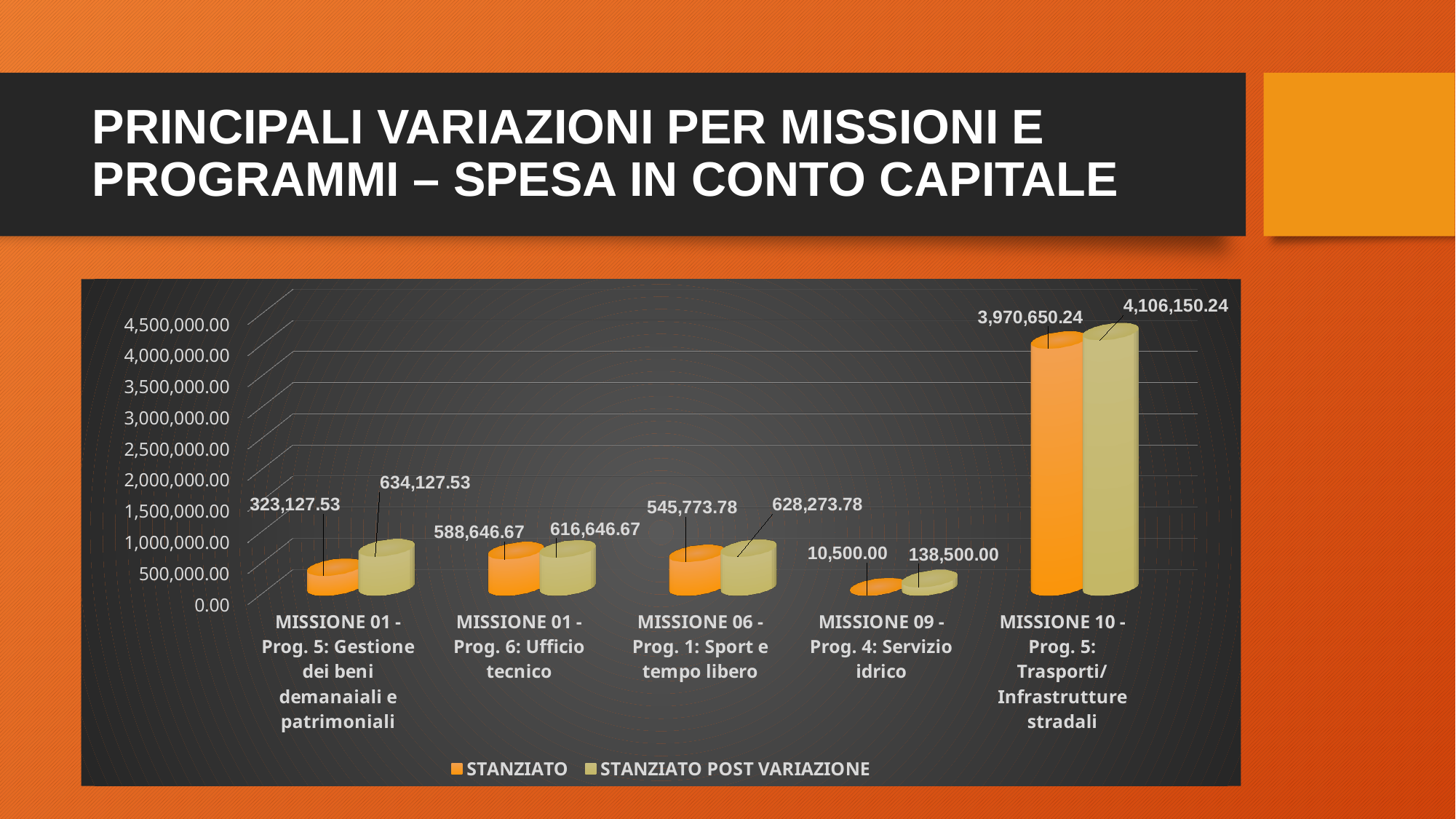
Which category has the highest STANZIATO value? MISSIONE 10 - Prog. 5: Trasporti/Infrastrutture stradali What is the STANZIATO POST VARIAZIONE value for MISSIONE 10 - Prog. 5: Trasporti/Infrastrutture stradali? 4,106,150.24 What is the STANZIATO POST VARIAZIONE value for MISSIONE 01 - Prog. 6: Ufficio tecnico? 616,646.67 Which is larger: the STANZIATO value for MISSIONE 01 - Prog. 6: Ufficio tecnico or the STANZIATO value for MISSIONE 06 - Prog. 1: Sport e tempo libero? MISSIONE 01 - Prog. 6: Ufficio tecnico What is the STANZIATO value for MISSIONE 06 - Prog. 1: Sport e tempo libero? 545,773.78 What is the difference between the STANZIATO POST VARIAZIONE and STANZIATO values for MISSIONE 01 - Prog. 5: Gestione dei beni demaniali e patrimoniali? 311,000.00 What is the difference between the STANZIATO POST VARIAZIONE and STANZIATO values for MISSIONE 10 - Prog. 5: Trasporti/Infrastrutture stradali? 135,500.00 Which category has the lowest STANZIATO POST VARIAZIONE value? MISSIONE 09 - Prog. 4: Servizio idrico What is the STANZIATO value for MISSIONE 09 - Prog. 4: Servizio idrico? 10,500.00 How many categories are shown on the x axis of the chart? 5 How many series does the chart legend list? 2 What kind of chart is shown on the slide? Bar chart